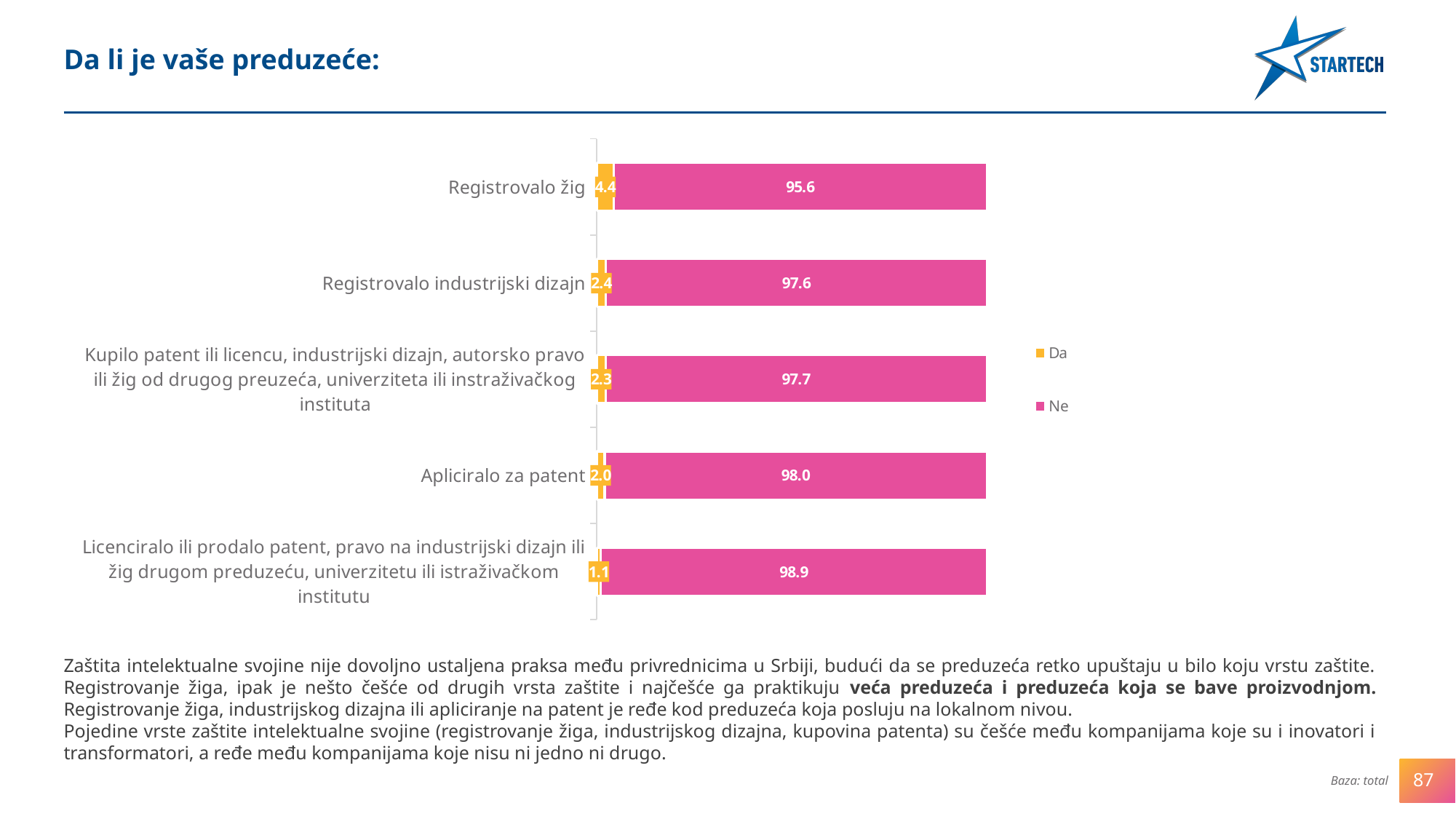
What is the 'Ne' value for 'Registrovalo industrijski dizajn'? 97.6 What is the 'Da' value for 'Licenciralo ili prodalo patent, pravo na industrijski dizajn ili žig drugom preduzeću, univerzitetu ili istraživačkom institutu'? 1.1 Which category has the highest 'Da' value? Registrovalo žig Which category has the lowest 'Da' value? Licenciralo ili prodalo patent, pravo na industrijski dizajn ili žig drugom preduzeću, univerzitetu ili istraživačkom institutu What is the total of the stacked bar for 'Kupilo patent ili licencu, industrijski dizajn, autorsko pravo ili žig od drugog preuzeća, univerziteta ili instraživačkog instituta'? 100.0 How many categories are shown in the chart? 5 What kind of chart is shown on the slide? Stacked bar chart How many series does the legend list? 2 Which is larger: the 'Ne' value for 'Apliciralo za patent' or for 'Registrovalo žig'? Apliciralo za patent What is the 'Da' value for 'Registrovalo žig'? 4.4 What is the 'Ne' value for 'Apliciralo za patent'? 98.0 What is the difference between the 'Da' values for 'Registrovalo žig' and 'Registrovalo industrijski dizajn'? 2.0